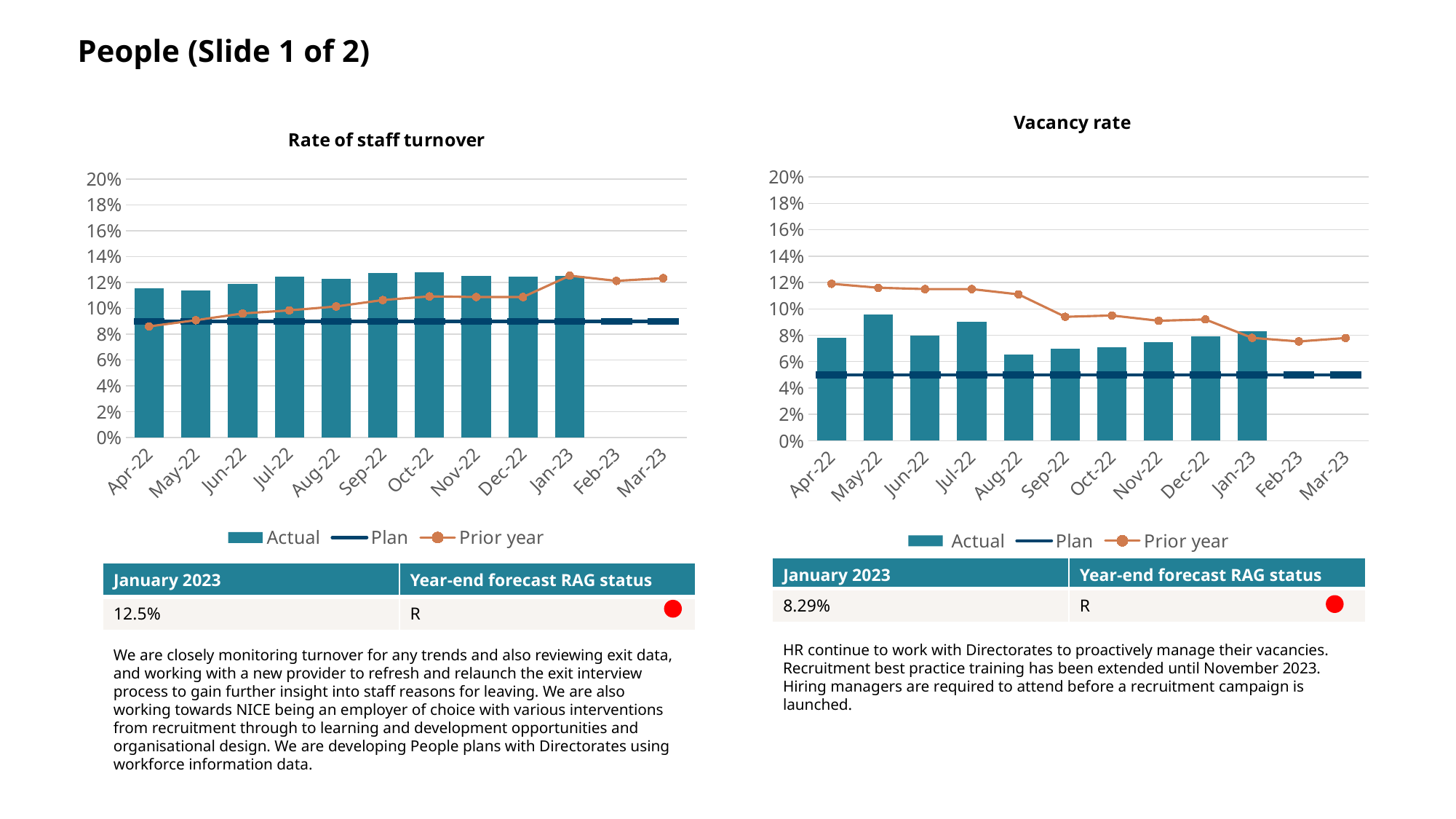
In the 'Rate of staff turnover' chart, how many series does the legend list? 3 In the 'Vacancy rate' chart, what is the Actual value for January 2023? 8.29% In the 'Rate of staff turnover' chart, does the Prior year line rise or fall from Apr-22 to Jan-23? rise In the 'Rate of staff turnover' chart, what is the Actual value for January 2023? 12.5% In the 'Rate of staff turnover' chart, is the Actual value for Apr-22 greater or less than 10%? greater In the 'Vacancy rate' chart, which month has the lowest Actual bar? Aug-22 In the 'Rate of staff turnover' chart, which is larger, the Actual value for Apr-22 or for Jan-23? Jan-23 What type of chart is the 'Rate of staff turnover' chart? Bar chart with line series In the 'Rate of staff turnover' chart, how many months are shown on the x axis? 12 In the 'Vacancy rate' chart, which month has the highest Actual bar? May-22 In the 'Vacancy rate' chart, is the Actual value for Aug-22 greater or less than 8%? less In the 'Vacancy rate' chart, does the Prior year line rise or fall from Apr-22 to Mar-23? fall